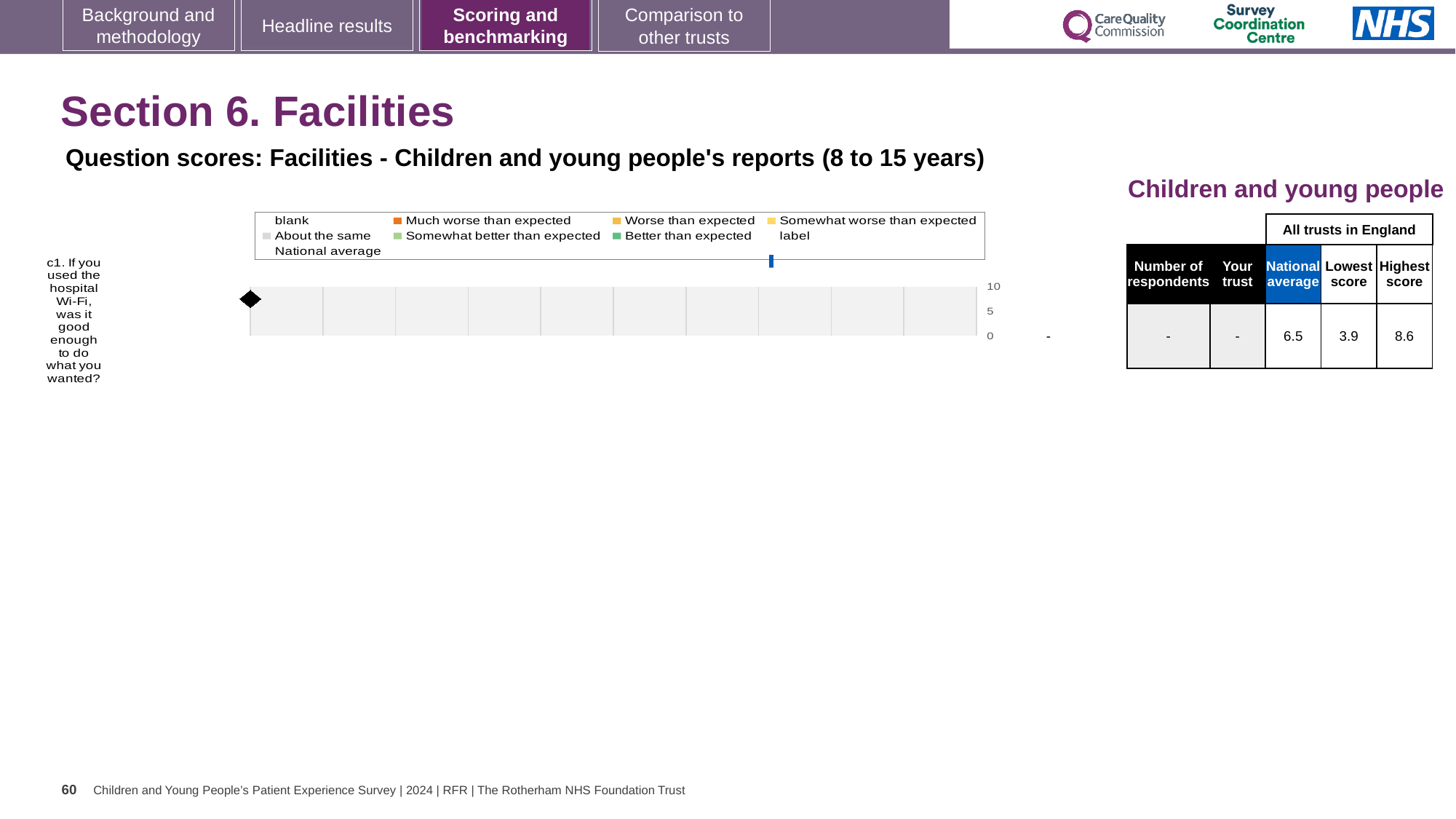
How many entries does the chart legend list? 9 In the accompanying table, what is the National average score for question c1? 6.5 In the accompanying table, what is the difference between the Highest score and the Lowest score for question c1? 4.7 In the accompanying table, is the National average for question c1 greater or less than 5? greater What is the highest value shown on the chart's axis? 10 In the accompanying table, what is the Highest score across all trusts in England for question c1? 8.6 What kind of chart is shown on the slide? bar chart In the accompanying table, what is the Lowest score across all trusts in England for question c1? 3.9 How many question categories are plotted on the chart? 1 In the accompanying table, what value is shown for Your trust for question c1? - Which question is plotted on the chart? c1. If you used the hospital Wi-Fi, was it good enough to do what you wanted?